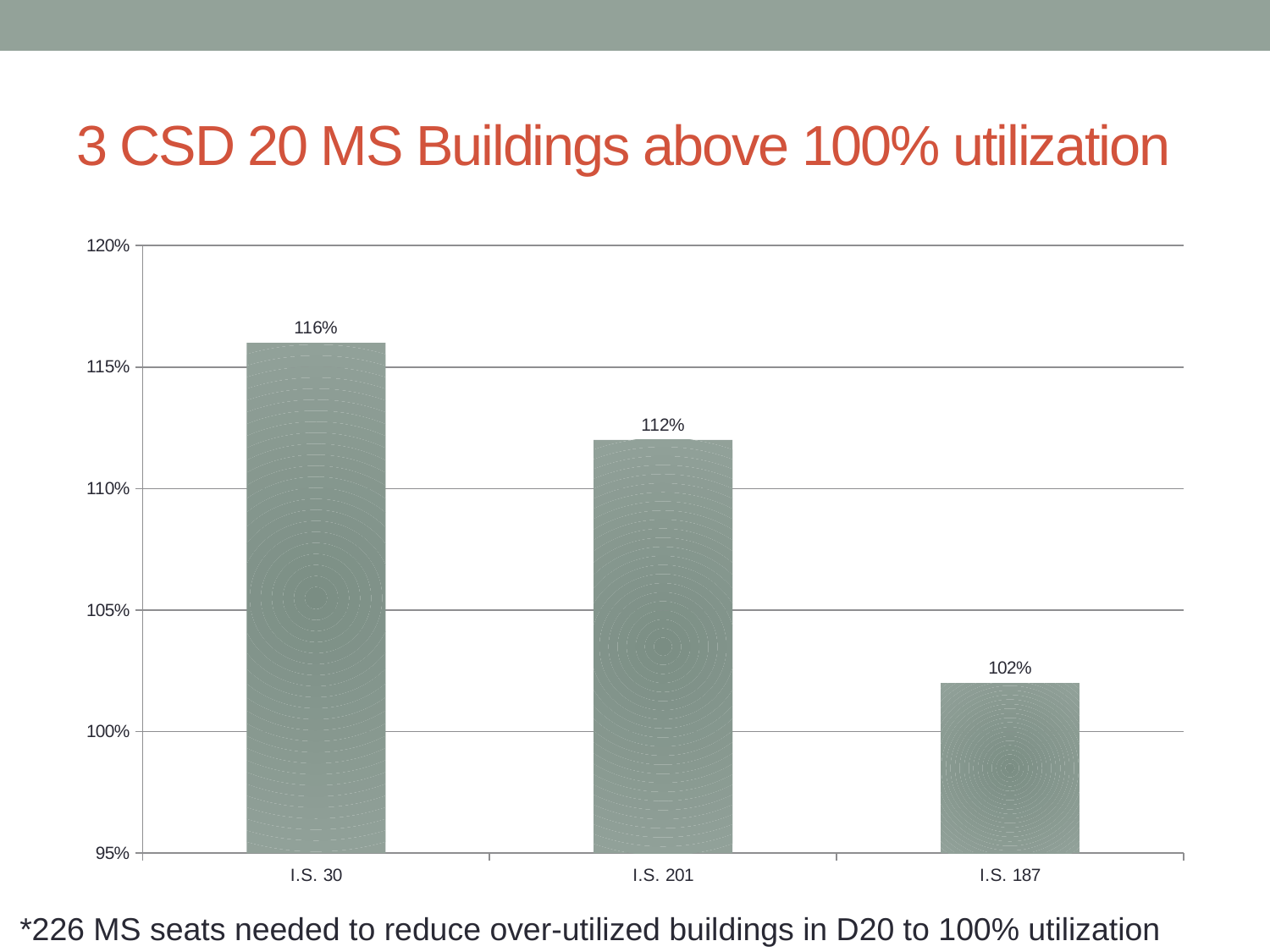
Which building has the lowest utilization? I.S. 187 Is the value for I.S. 201 greater or less than 110%? greater Which has a higher utilization, I.S. 201 or I.S. 187? I.S. 201 Do the values rise or fall from left to right across the chart? Fall What is the difference in utilization between I.S. 30 and I.S. 187? 14% What kind of chart is shown on the slide? Bar chart What is the utilization value for I.S. 30? 116% Which building has the highest utilization? I.S. 30 What is the utilization value for I.S. 187? 102% What is the utilization value for I.S. 201? 112% How many buildings are shown in the chart? 3 What is the difference in utilization between I.S. 201 and I.S. 187? 10%